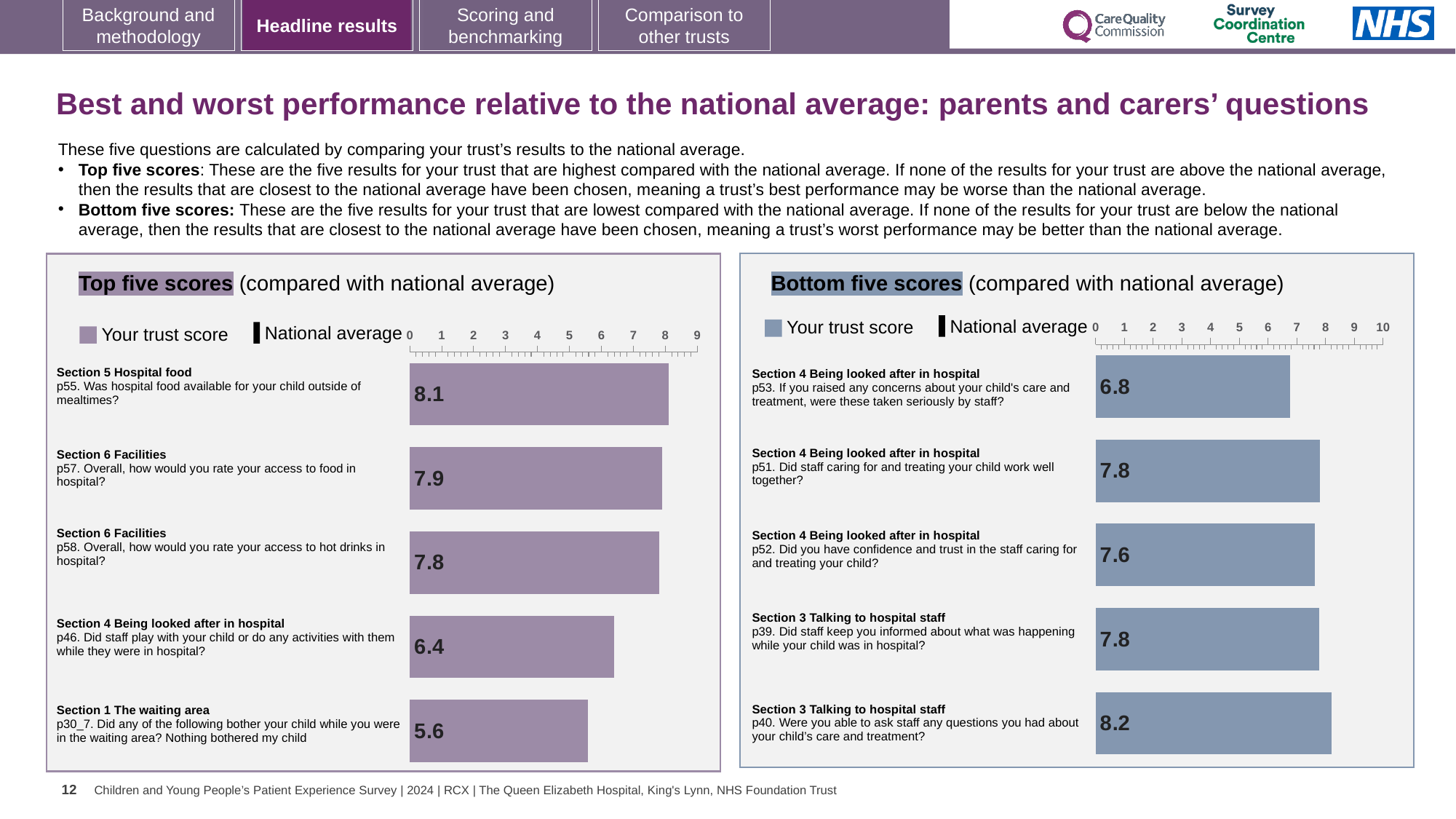
In the Bottom five scores chart, what is the trust score for p40 (able to ask staff any questions about your child's care and treatment)? 8.2 In the Top five scores chart, what is the trust score for p55 (Was hospital food available for your child outside of mealtimes)? 8.1 In the Top five scores chart, is the trust score for p58 greater or less than 7? greater How many series does the legend of the Top five scores chart list? 2 In the Bottom five scores chart, which has the larger trust score, p52 or p40? p40 In the Top five scores chart, which question has the highest trust score? p55. Was hospital food available for your child outside of mealtimes? What type of chart is the Top five scores chart? Bar chart How many questions are shown in the Bottom five scores chart? 5 In the Top five scores chart, what is the trust score for p30_7 (Nothing bothered my child in the waiting area)? 5.6 In the Top five scores chart, what is the difference between the trust scores for p57 and p46? 1.5 In the Bottom five scores chart, which question has the lowest trust score? p53. If you raised any concerns about your child's care and treatment, were these taken seriously by staff? In the Bottom five scores chart, what is the trust score for p53 (concerns about your child's care taken seriously by staff)? 6.8